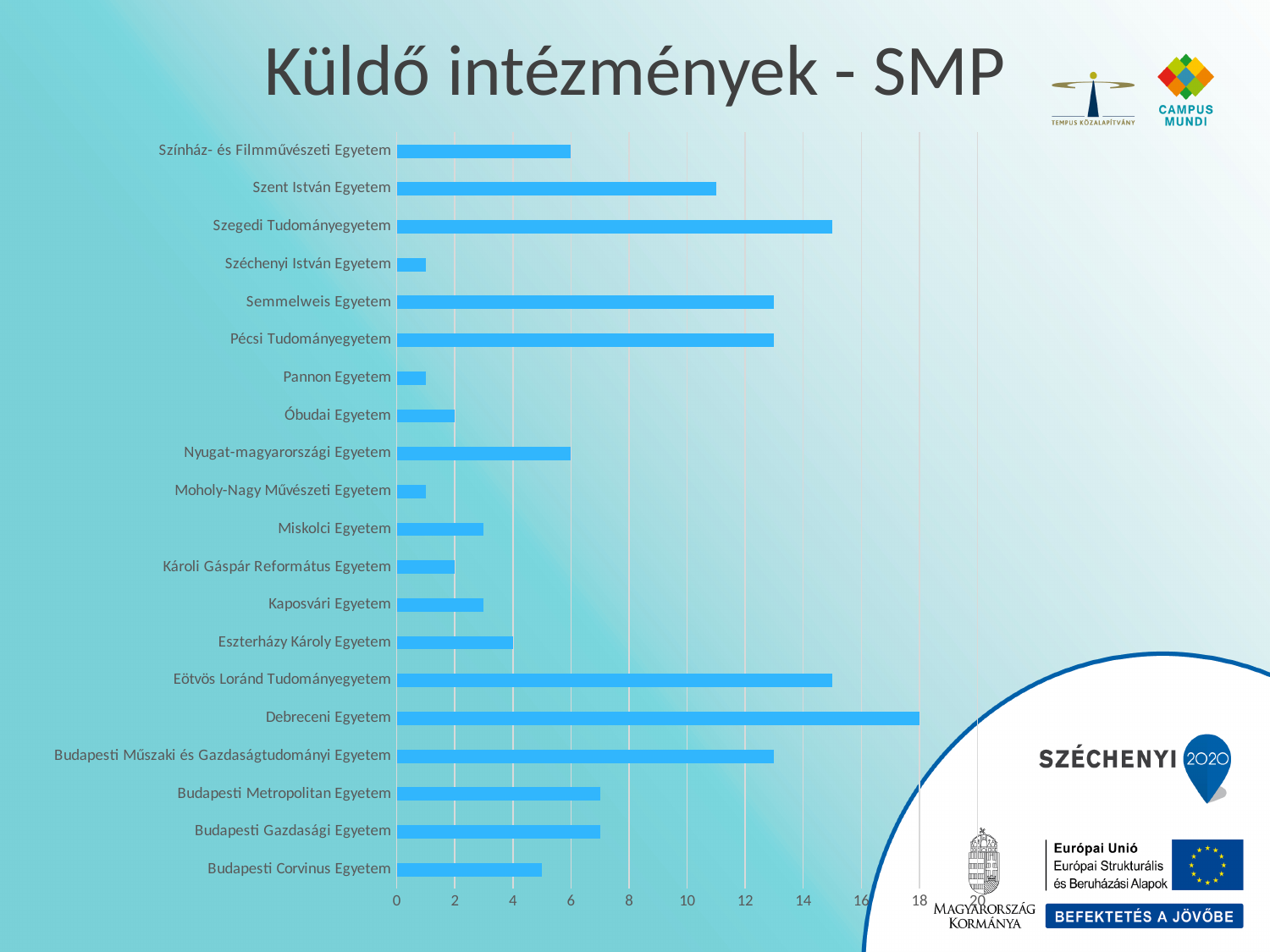
Which institution has the highest value in the chart? Debreceni Egyetem How many institutions (categories) are shown in the chart? 20 Which is larger, the value for Szegedi Tudományegyetem or the value for Semmelweis Egyetem? Szegedi Tudományegyetem What is the value for Színház- és Filmművészeti Egyetem? 6 What is the title of the chart on the slide? Küldő intézmények - SMP Is the value for Szegedi Tudományegyetem greater or less than 14? greater Is the value for Budapesti Corvinus Egyetem greater or less than 6? less What is the difference between the values for Debreceni Egyetem and Eszterházy Károly Egyetem? 14 What kind of chart is shown on the slide? bar chart What is the value for Debreceni Egyetem? 18 What is the value for Óbudai Egyetem? 2 What is the value for Eszterházy Károly Egyetem? 4